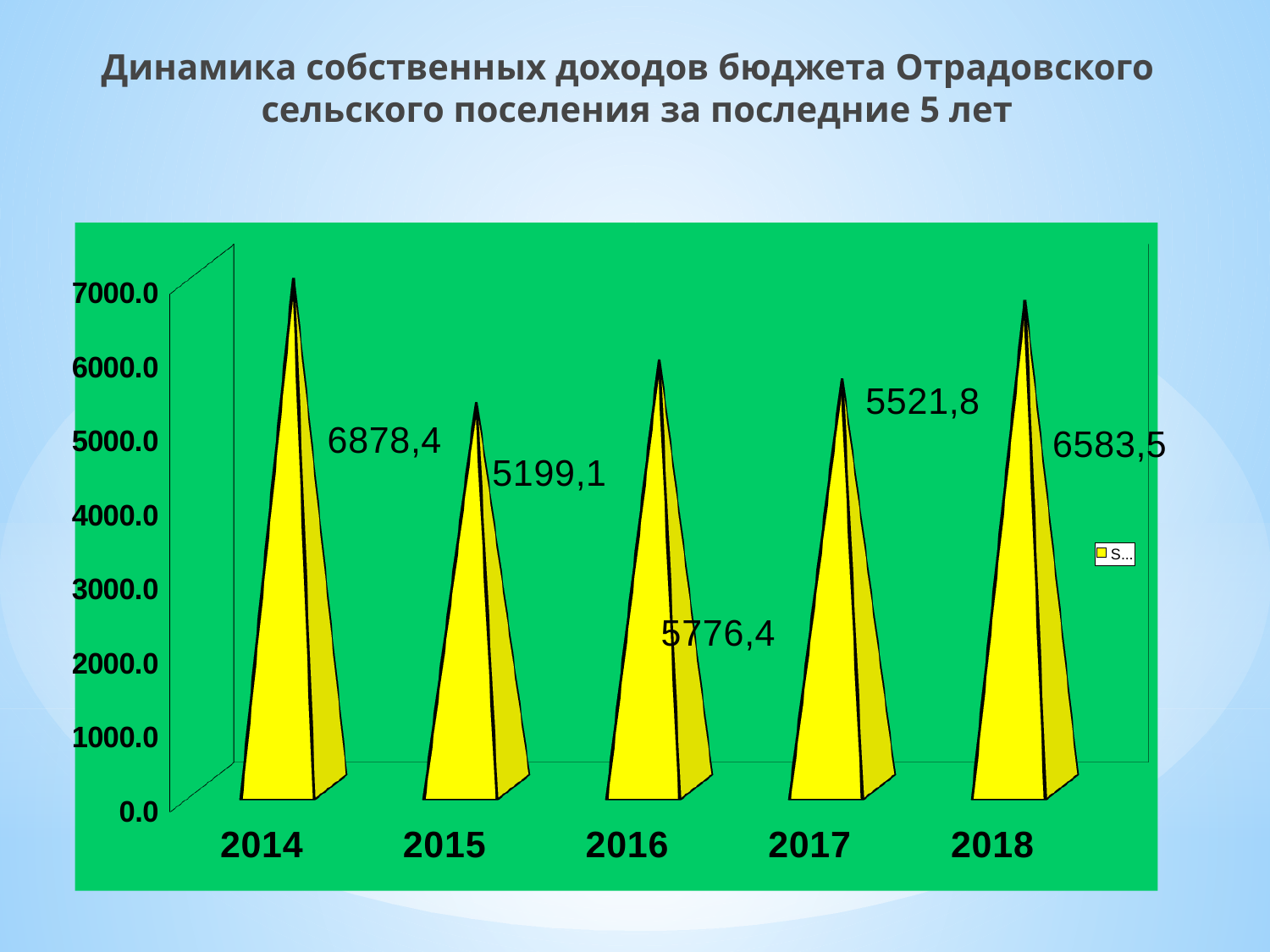
Did the value rise or fall from 2014 to 2015? fall What is the value for 2016? 5776,4 What is the value for 2014? 6878,4 What is the value for 2015? 5199,1 What is the value for 2017? 5521,8 Which year has the lowest value? 2015 Is the value for 2018 greater or less than 6000.0? greater What is the difference between the values for 2014 and 2015? 1679,3 Which year has the highest value? 2014 Which is larger, the value for 2016 or the value for 2017? 2016 How many years are shown on the x axis? 5 What is the value for 2018? 6583,5